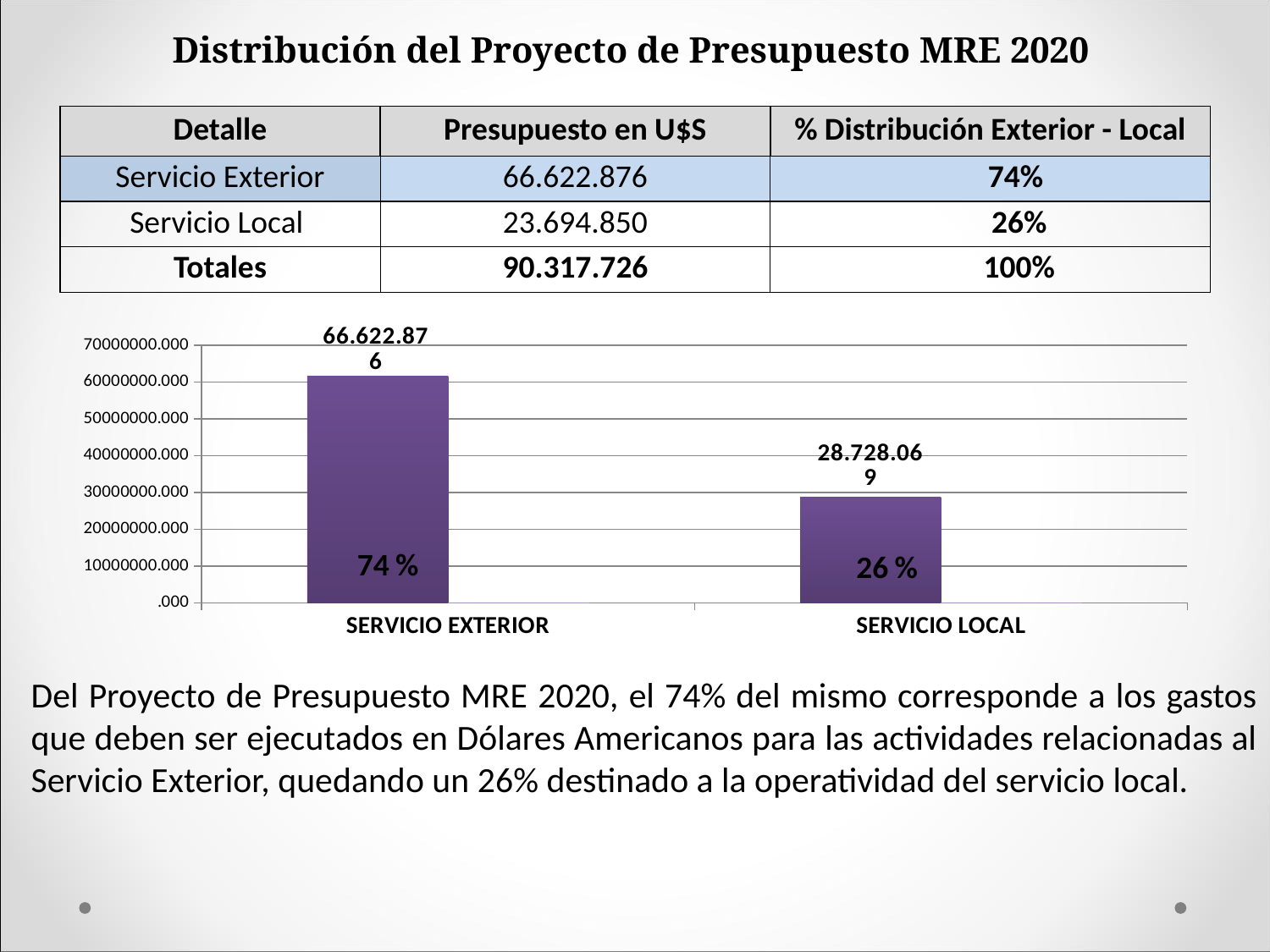
Which category has the lowest value in the chart? SERVICIO LOCAL What percentage label is printed inside the SERVICIO LOCAL bar? 26 % Which category has the highest value in the chart? SERVICIO EXTERIOR What is the value shown for SERVICIO LOCAL in the chart? 28.728.069 Is the value for SERVICIO LOCAL greater or less than 40000000.000? less How many categories are shown in the chart? 2 What is the difference between the values for SERVICIO EXTERIOR and SERVICIO LOCAL in the chart? 37.894.807 What is the value shown for SERVICIO EXTERIOR in the chart? 66.622.876 Is the value for SERVICIO EXTERIOR greater or less than 50000000.000? greater What kind of chart is shown on the slide? bar chart What percentage label is printed inside the SERVICIO EXTERIOR bar? 74 % Which is larger in the chart, SERVICIO EXTERIOR or SERVICIO LOCAL? SERVICIO EXTERIOR